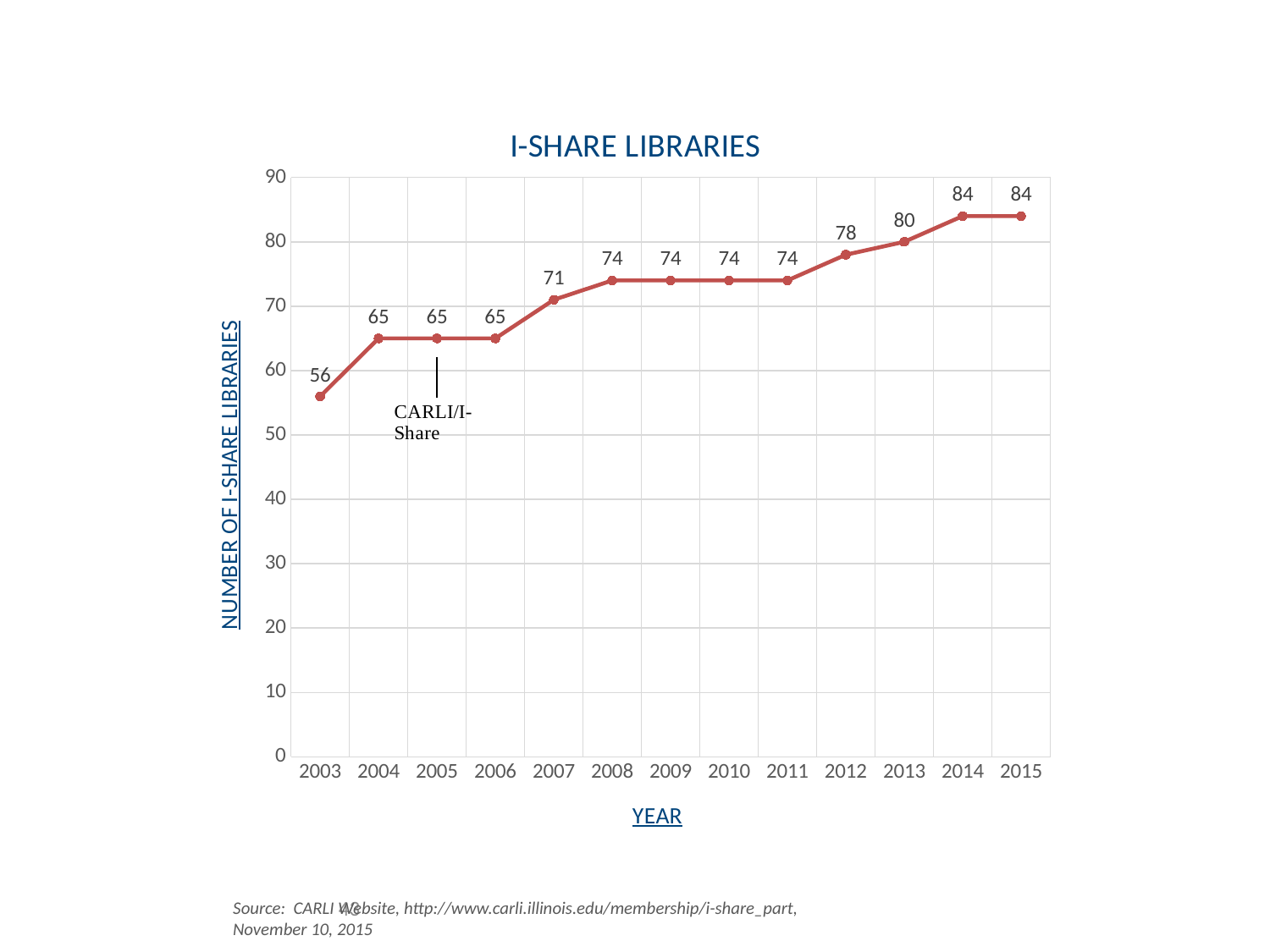
How many years are plotted on the chart? 13 What is the number of I-Share libraries in 2003? 56 Is the value for 2010 greater or less than 70? greater Do the values rise or fall from 2003 to 2015? rise What is the highest value shown on the chart? 84 What is the number of I-Share libraries in 2013? 80 Which is larger, the value for 2004 or the value for 2008? 2008 What is the number of I-Share libraries in 2007? 71 What is the difference between the values for 2012 and 2011? 4 What kind of chart is shown on the slide? line chart What is the difference between the number of I-Share libraries in 2015 and in 2003? 28 Which year has the lowest number of I-Share libraries? 2003